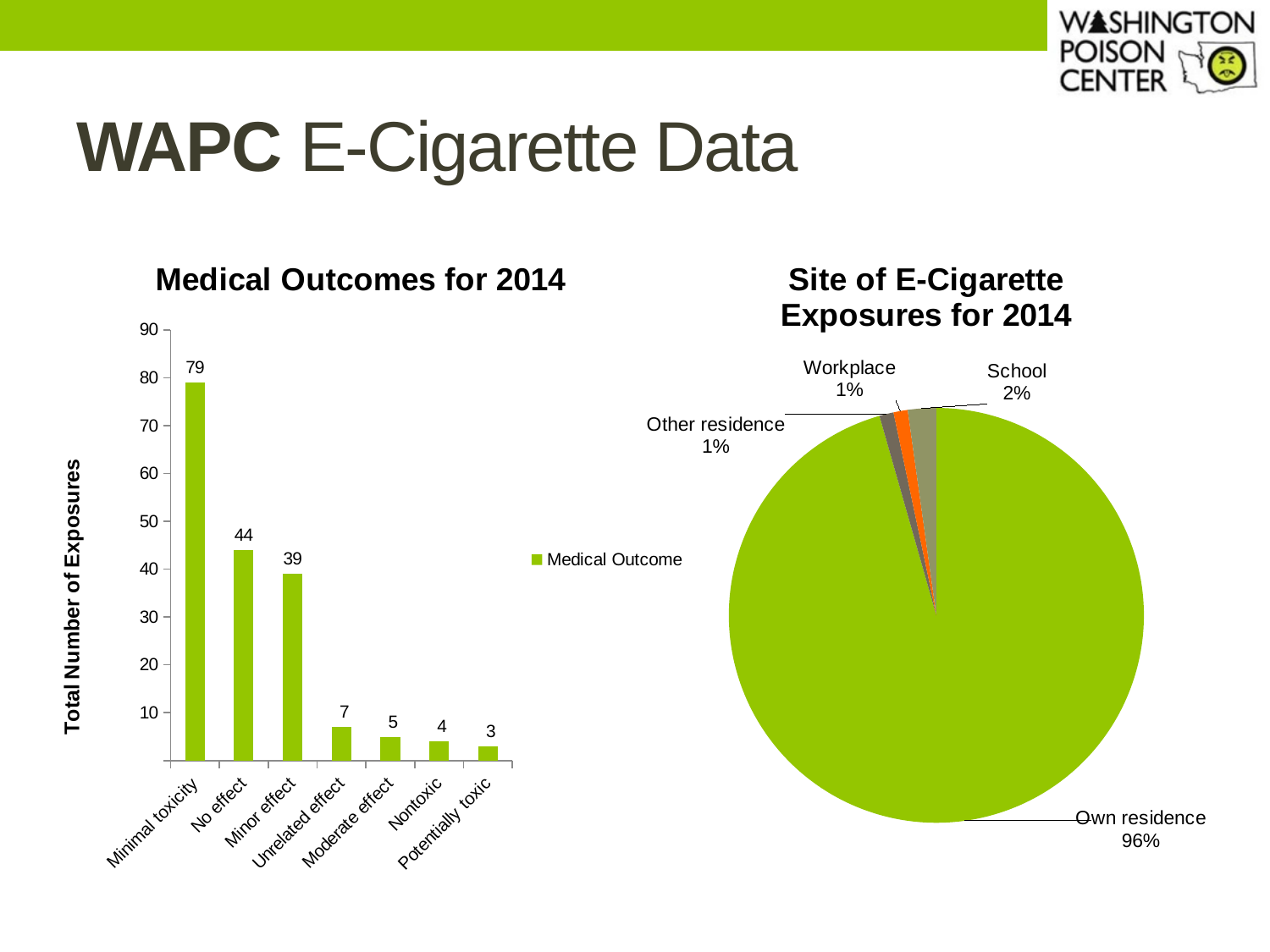
How many slices are in the 'Site of E-Cigarette Exposures for 2014' pie chart? 4 In the 'Site of E-Cigarette Exposures for 2014' chart, what share of exposures occurred at School? 2% In the 'Site of E-Cigarette Exposures for 2014' chart, what share of exposures occurred at Own residence? 96% In the 'Medical Outcomes for 2014' chart, which category has the lowest value? Potentially toxic In the 'Medical Outcomes for 2014' chart, what is the value for Minimal toxicity? 79 In the 'Medical Outcomes for 2014' chart, what is the value for Minor effect? 39 In the 'Medical Outcomes for 2014' chart, which category has the highest value? Minimal toxicity What is the y-axis label of the 'Medical Outcomes for 2014' chart? Total Number of Exposures How many categories are shown in the 'Medical Outcomes for 2014' chart? 7 In the 'Medical Outcomes for 2014' chart, what is the difference between the values for Minimal toxicity and No effect? 35 In the 'Medical Outcomes for 2014' chart, which is larger, Unrelated effect or Moderate effect? Unrelated effect What kind of chart is 'Medical Outcomes for 2014'? Bar chart